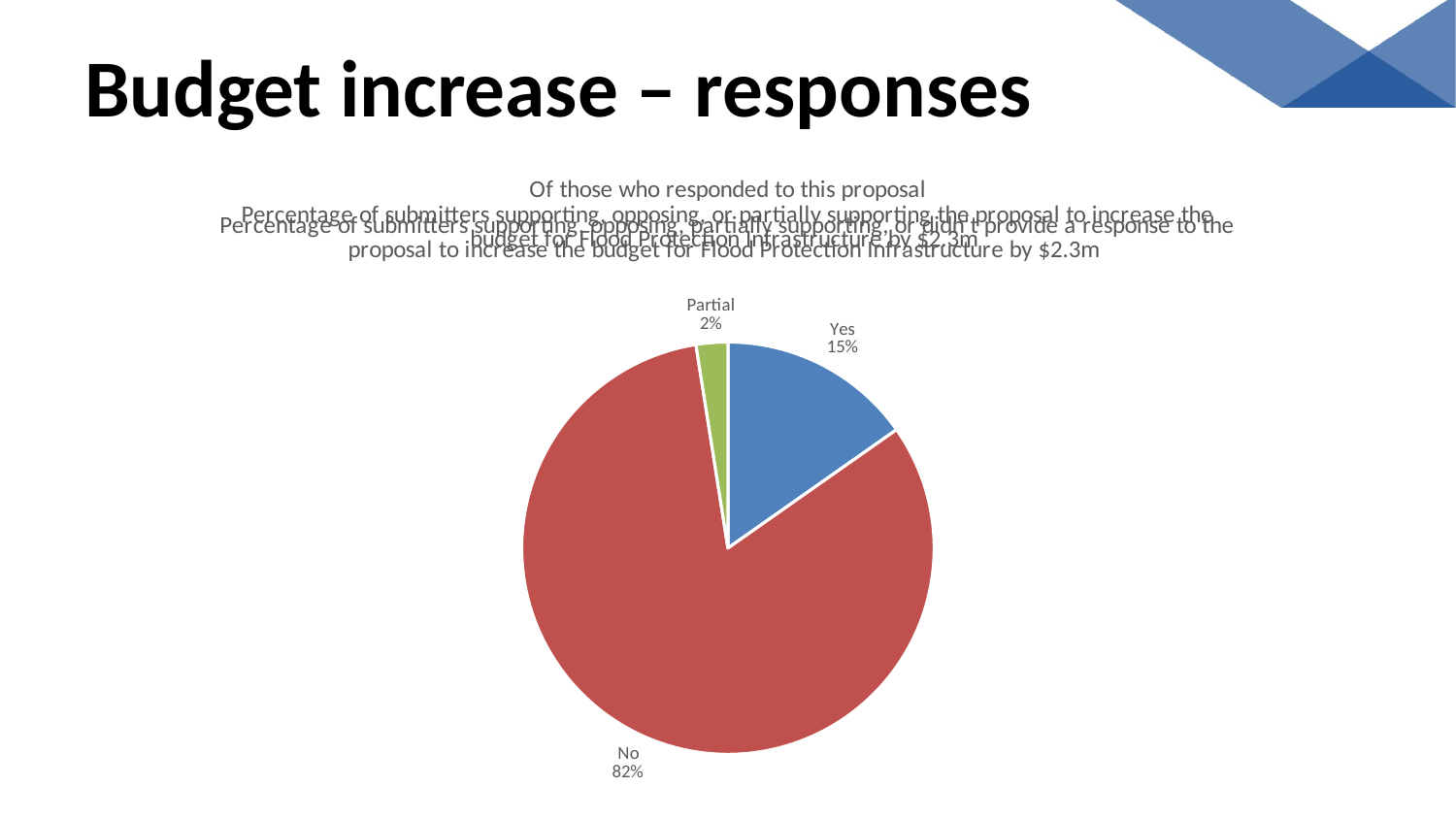
Which response category has the largest share of the pie? No Which is larger, the "Yes" slice or the "Partial" slice? Yes What percentage of submitters responded "No" to the budget increase proposal? 82% What type of chart is shown on the slide? Pie chart What percentage of submitters gave a "Partial" response? 2% What is the difference in percentage points between the "Yes" and "Partial" slices? 13 What percentage of submitters responded "Yes"? 15% Which response category has the smallest share of the pie? Partial What colour is the "Partial" slice of the pie chart? Green What colour is the "No" slice of the pie chart? Red What is the difference in percentage points between the "No" and "Yes" slices? 67 How many slices does the pie chart have? 3